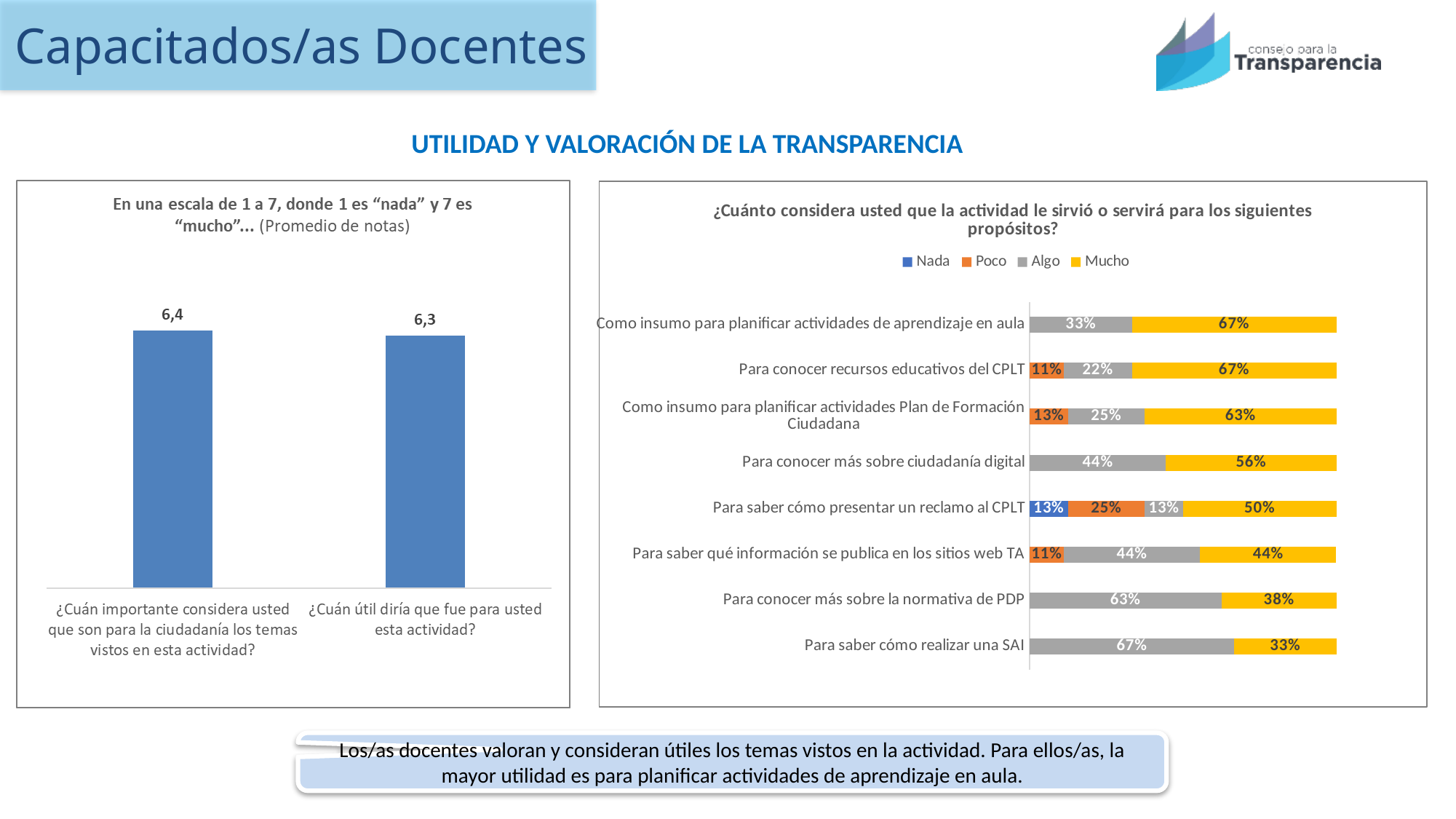
In the right chart (¿Cuánto considera usted que la actividad le sirvió...?), what percentage answered "Mucho" for "Como insumo para planificar actividades de aprendizaje en aula"? 67% In the right chart (¿Cuánto considera usted que la actividad le sirvió...?), which colour represents the "Mucho" series? Yellow In the left chart (scale 1 to 7), what is the average score for "¿Cuán importante considera usted que son para la ciudadanía los temas vistos en esta actividad?"? 6,4 In the right chart (¿Cuánto considera usted que la actividad le sirvió...?), what percentage answered "Algo" for "Para conocer más sobre la normativa de PDP"? 63% In the left chart (scale 1 to 7), what is the average score for "¿Cuán útil diría que fue para usted esta actividad?"? 6,3 In the right chart (¿Cuánto considera usted que la actividad le sirvió...?), what percentage answered "Nada" for "Para saber cómo presentar un reclamo al CPLT"? 13% In the left chart (scale 1 to 7), how many bars are plotted? 2 In the right chart (¿Cuánto considera usted que la actividad le sirvió...?), how many categories (purposes) are shown? 8 In the right chart (¿Cuánto considera usted que la actividad le sirvió...?), how many series does the legend list? 4 In the right chart (¿Cuánto considera usted que la actividad le sirvió...?), what is the difference between the "Mucho" percentages for "Para conocer más sobre ciudadanía digital" and "Para saber cómo realizar una SAI"? 23% In the left chart (scale 1 to 7), what kind of chart is shown? Bar chart In the right chart (¿Cuánto considera usted que la actividad le sirvió...?), which purpose has the lowest "Mucho" percentage? Para saber cómo realizar una SAI